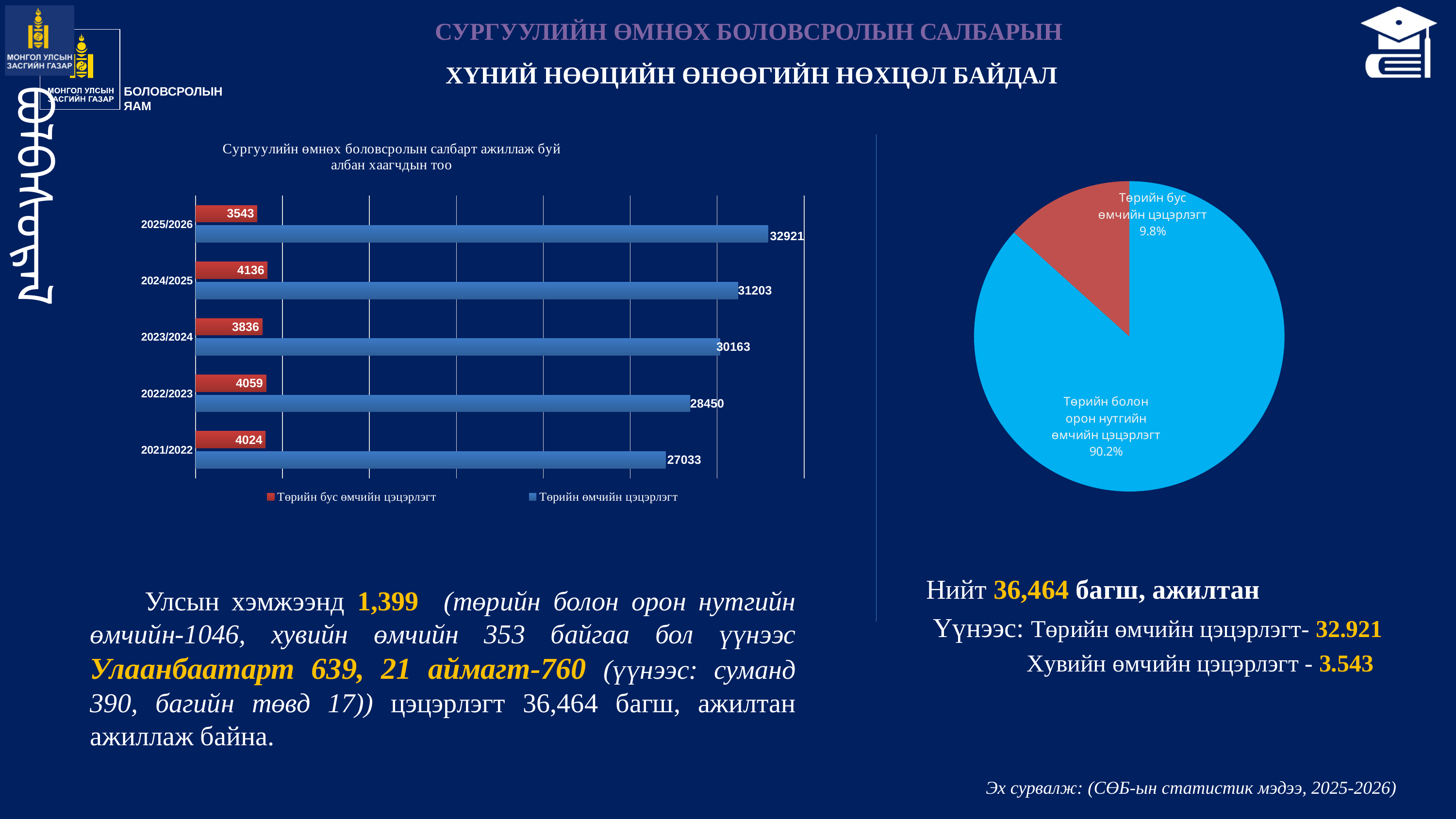
How many series does the bar chart legend list? 2 In the bar chart, what is the difference between the Төрийн өмчийн цэцэрлэгт values for 2025/2026 and 2024/2025? 1718 What kind of chart is the chart on the right side of the slide? pie chart In the pie chart, what share is Төрийн бус өмчийн цэцэрлэгт? 9.8% How many years are shown in the bar chart? 5 In the bar chart, what is the value for Төрийн өмчийн цэцэрлэгт in 2025/2026? 32921 In the bar chart, does the Төрийн өмчийн цэцэрлэгт value rise or fall from 2021/2022 to 2025/2026? rise In the bar chart, what is the value for Төрийн өмчийн цэцэрлэгт in 2023/2024? 30163 In the bar chart, which year has the highest value for Төрийн бус өмчийн цэцэрлэгт? 2024/2025 In the bar chart, what is the value for Төрийн бус өмчийн цэцэрлэгт in 2021/2022? 4024 In the bar chart, which year has the lowest value for Төрийн өмчийн цэцэрлэгт? 2021/2022 In the bar chart, which is larger: Төрийн бус өмчийн цэцэрлэгт in 2022/2023 or in 2023/2024? 2022/2023